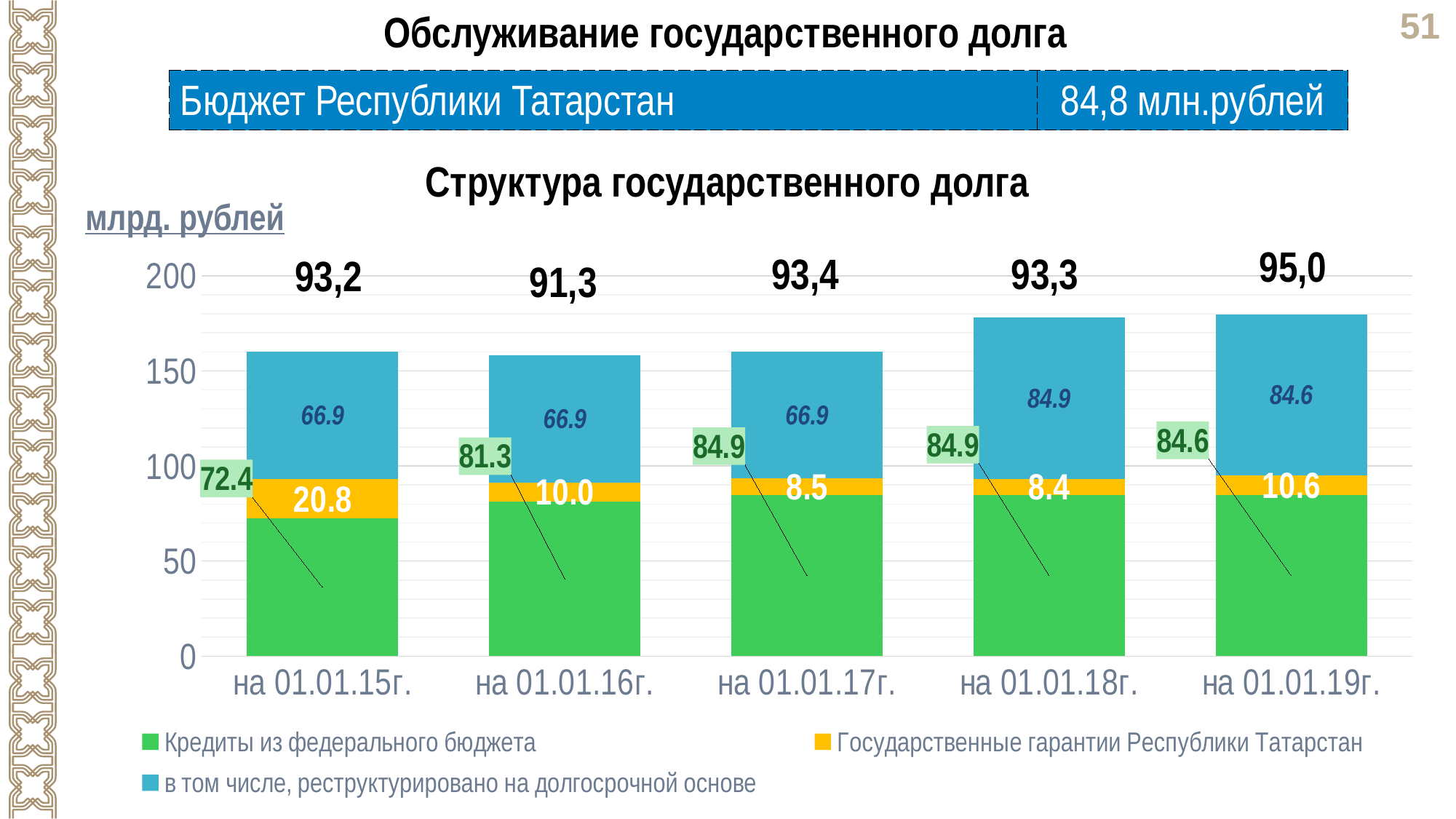
What is the value of «Государственные гарантии Республики Татарстан» for на 01.01.16г.? 10.0 On which date is the value of «Государственные гарантии Республики Татарстан» highest? на 01.01.15г. What total is printed above the bar for на 01.01.19г.? 95,0 What is the value of «в том числе, реструктурировано на долгосрочной основе» for на 01.01.18г.? 84.9 How many series does the chart legend list? 3 On which date is the printed total above the bar lowest? на 01.01.16г. What kind of chart is shown under the heading «Структура государственного долга»? stacked bar chart What is the difference between the «Государственные гарантии Республики Татарстан» values for на 01.01.15г. and на 01.01.16г.? 10.8 How many dates (categories) are shown on the x axis of the chart? 5 Which is larger: «Кредиты из федерального бюджета» for на 01.01.15г. or for на 01.01.17г.? на 01.01.17г. What unit is stated above the chart's y axis? млрд. рублей What is the value of «Кредиты из федерального бюджета» for на 01.01.15г.? 72.4